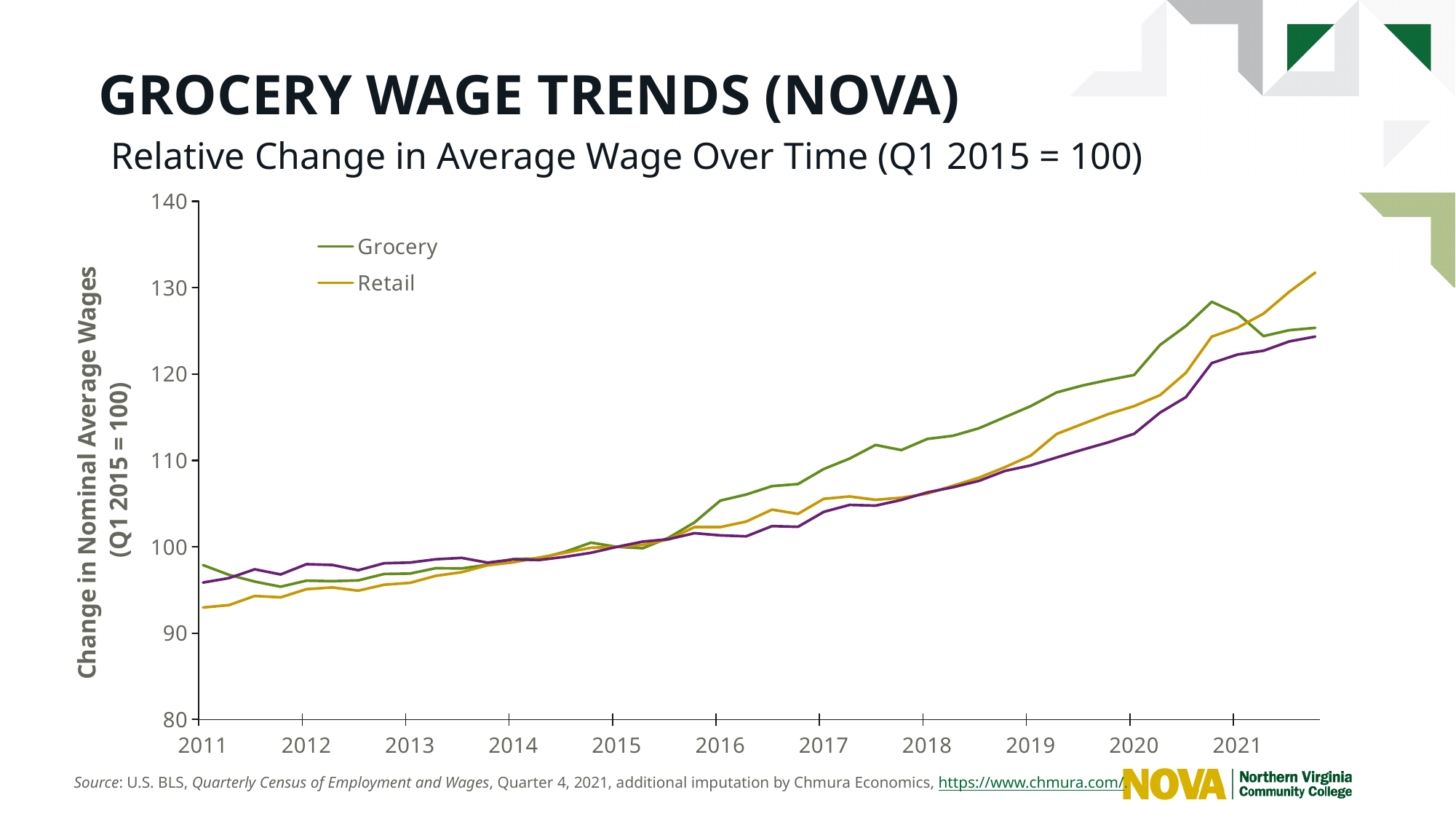
How many series does the legend list? 2 What kind of chart is shown on the slide? line chart Is the Retail value at the start of 2011 greater or less than 100? less At the start of 2011, which series is higher, Grocery or Retail? Grocery At the end of the series in 2021, which is higher, Grocery or Retail? Retail What is the title of the chart? Relative Change in Average Wage Over Time (Q1 2015 = 100) Do the Grocery values generally rise or fall from 2011 to 2021? rise Is the Retail value at the end of the series in 2021 greater or less than 120? greater Is the Grocery value at the start of 2020 greater or less than 110? greater Do the Retail values generally rise or fall from 2011 to 2021? rise How many year labels are shown on the x axis? 11 Which series are listed in the legend? Grocery and Retail